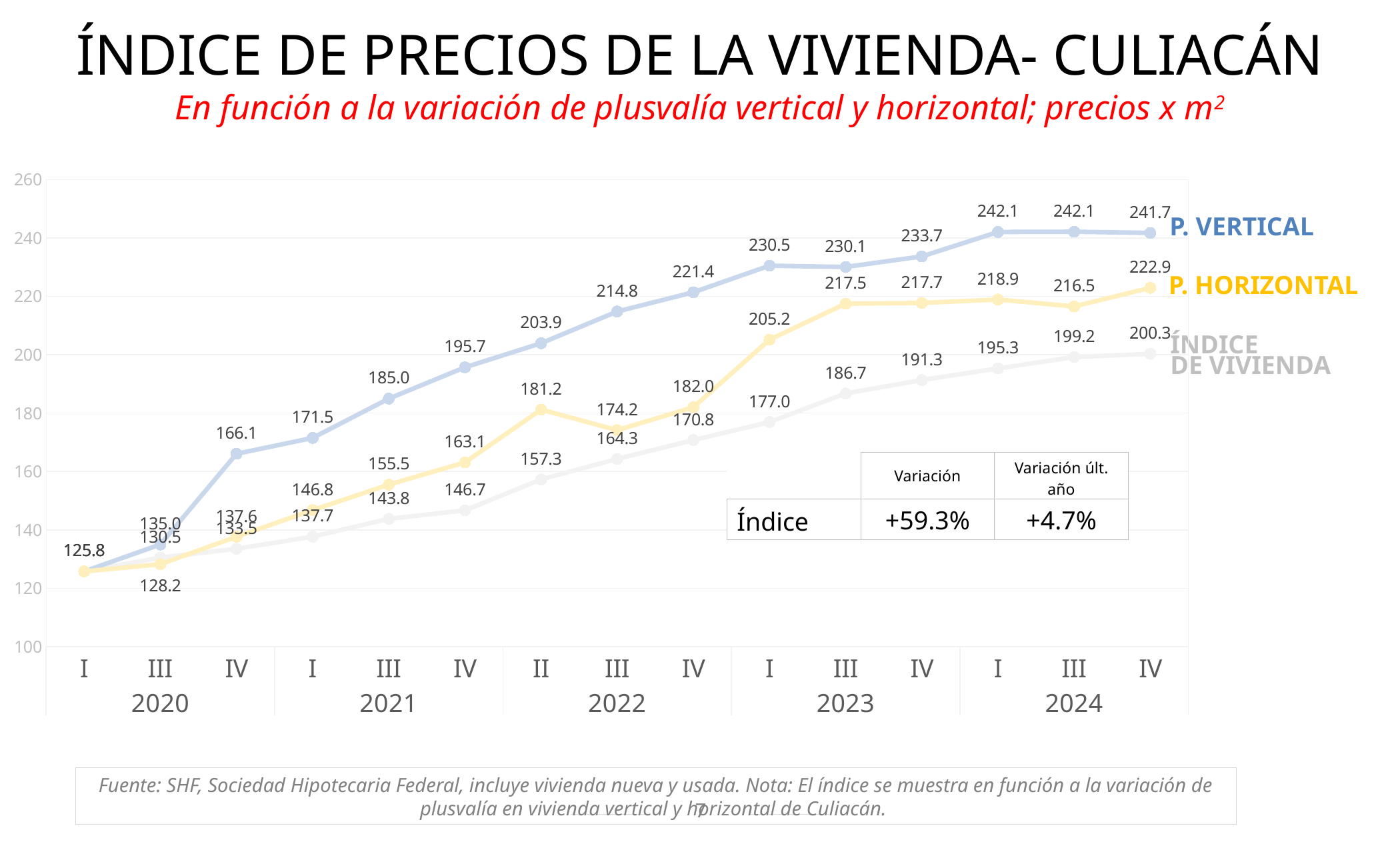
What is the value of P. VERTICAL in 2024 IV? 241.7 What is the value of P. HORIZONTAL in 2024 IV? 222.9 How many series are plotted on the chart? 3 Which series has the highest value in 2024 IV? P. VERTICAL What is the value of ÍNDICE DE VIVIENDA in 2024 IV? 200.3 Does the ÍNDICE DE VIVIENDA series rise or fall from 2020 I to 2024 IV? rise Is the value of P. VERTICAL in 2021 IV greater or less than 200? less What is the difference between P. VERTICAL and P. HORIZONTAL in 2024 IV? 18.8 How many time periods are plotted along the x axis? 15 What is the value of P. VERTICAL in 2023 I? 230.5 What kind of chart is shown on the slide? line chart Which is larger for P. HORIZONTAL: the value in 2022 II or in 2022 III? 2022 II